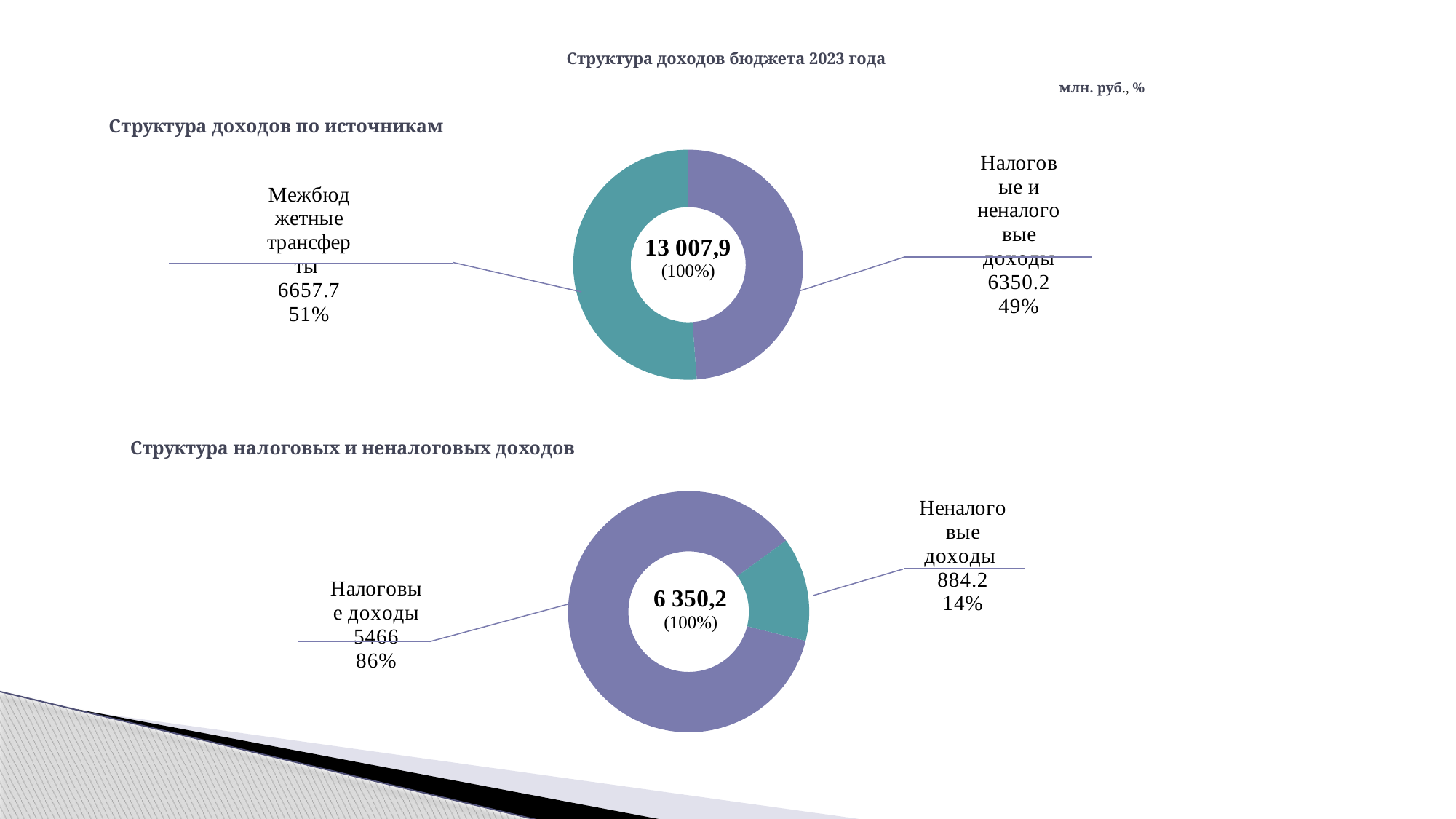
In the chart 'Структура налоговых и неналоговых доходов', what is the value for Налоговые доходы? 5466 In the chart 'Структура налоговых и неналоговых доходов', which category is the smallest? Неналоговые доходы In the chart 'Структура налоговых и неналоговых доходов', what is the value for Неналоговые доходы? 884.2 In the chart 'Структура доходов по источникам', what is the value for Межбюджетные трансферты? 6657.7 In the chart 'Структура налоговых и неналоговых доходов', what total is shown in the centre of the donut? 6 350,2 How many categories does the chart 'Структура доходов по источникам' show? 2 In the chart 'Структура доходов по источникам', what is the difference between Межбюджетные трансферты and Налоговые и неналоговые доходы? 307.5 In the chart 'Структура доходов по источникам', what share of the total do Налоговые и неналоговые доходы make up? 49% In the chart 'Структура налоговых и неналоговых доходов', what share of the total do Налоговые доходы make up? 86% What type of chart is used for 'Структура налоговых и неналоговых доходов'? Donut (pie) chart In the chart 'Структура доходов по источникам', which category is larger: Межбюджетные трансферты or Налоговые и неналоговые доходы? Межбюджетные трансферты In the chart 'Структура доходов по источникам', what total is shown in the centre of the donut? 13 007,9